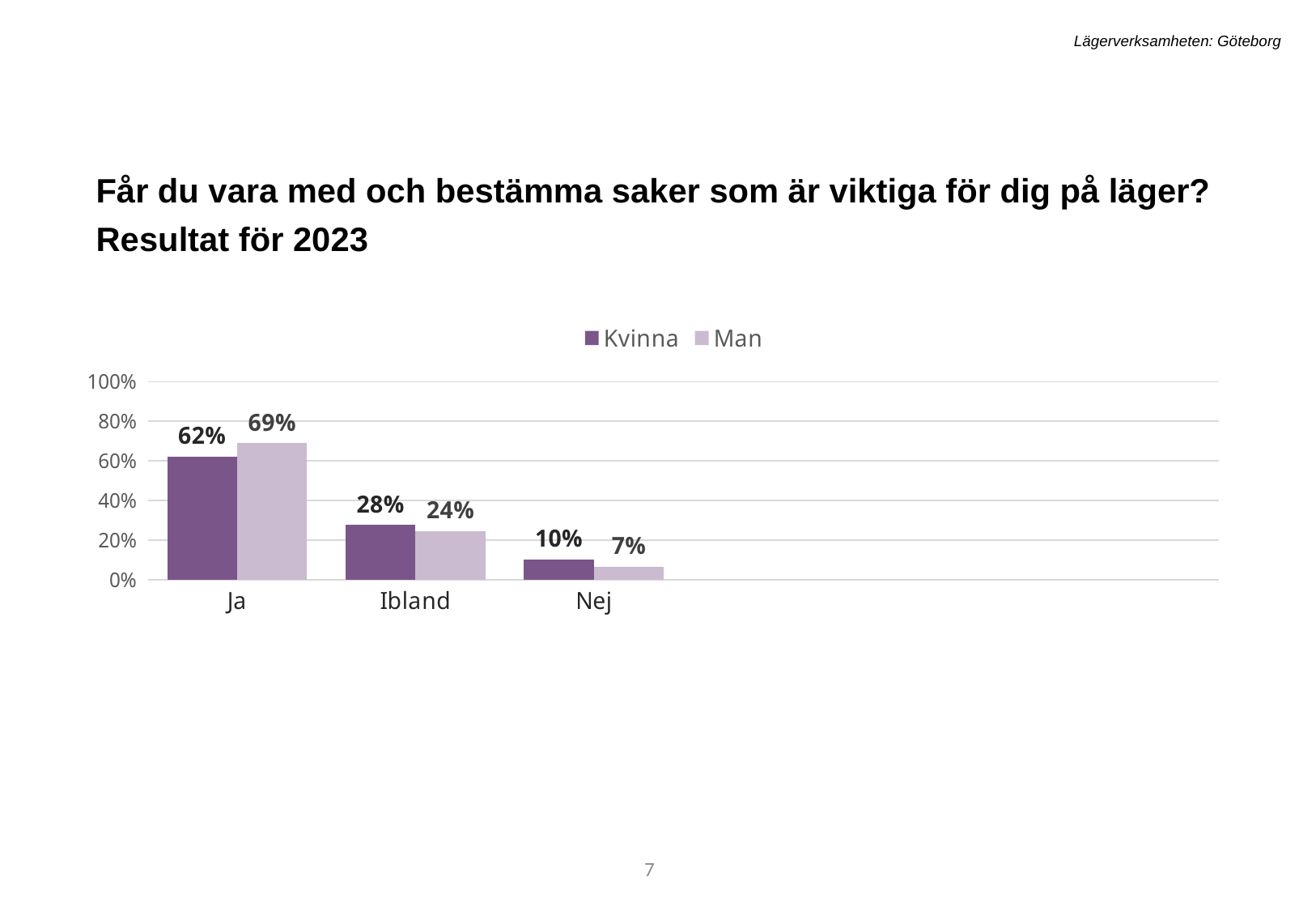
What is the value for Man in the Nej category? 7% Which category has the highest value for the Man series? Ja Which is larger in the Ibland category, Kvinna or Man? Kvinna What is the value for Kvinna in the Ja category? 62% What is the difference between the Man and Kvinna values in the Ja category? 7% Is the value for Kvinna in the Ja category greater or less than 40%? greater How many categories are shown on the x axis? 3 How many series does the legend list? 2 What kind of chart is shown on the slide? Bar chart Do the Kvinna values rise or fall from Ja to Nej along the x axis? Fall What is the value for Man in the Ibland category? 24% Which category has the lowest value for the Kvinna series? Nej